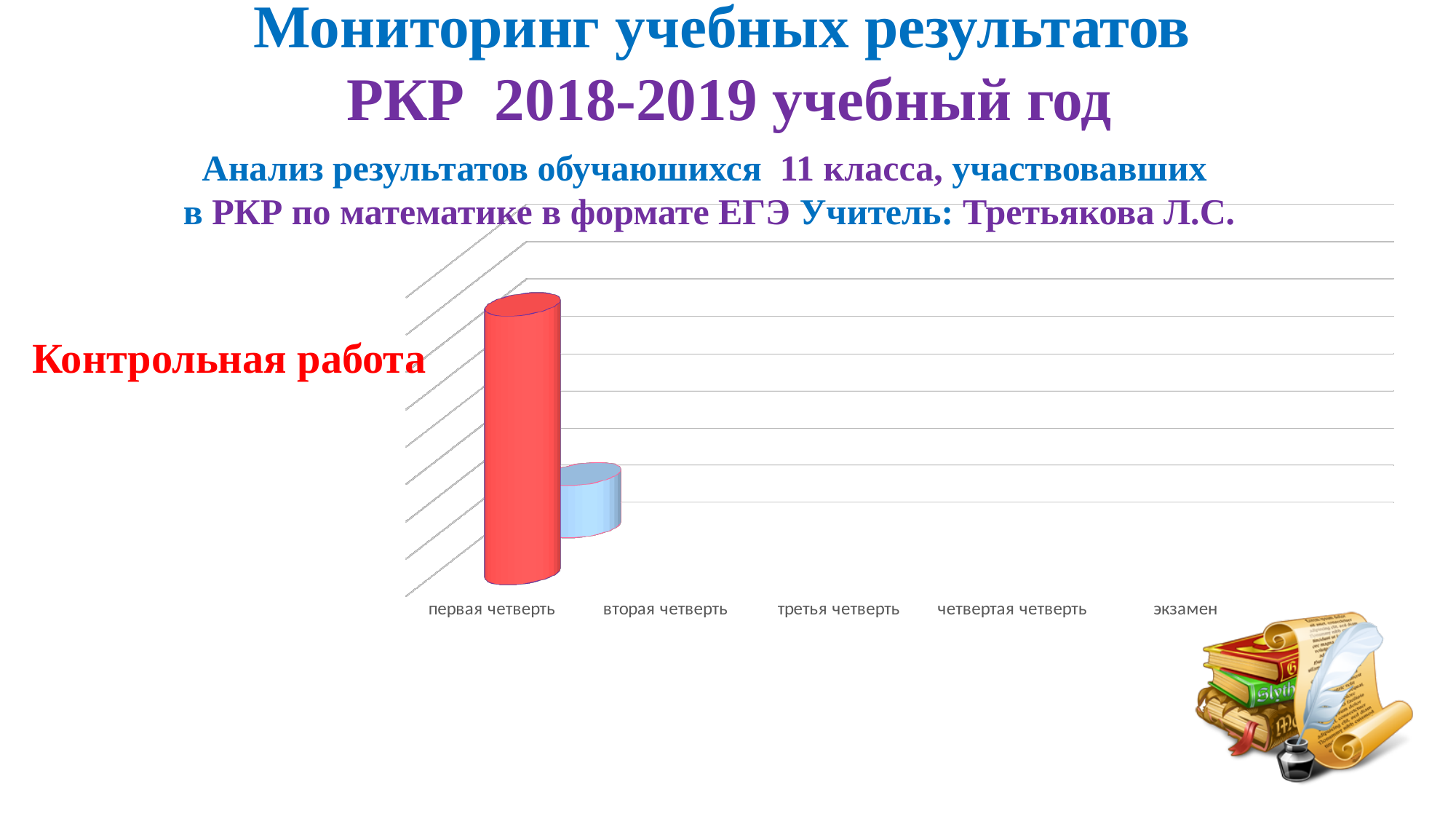
How many categories are labelled on the x axis of the chart? 5 What kind of chart is shown on the slide? bar chart What is the last category label on the x axis of the chart? экзамен Which category has the tallest bar in the chart? первая четверть